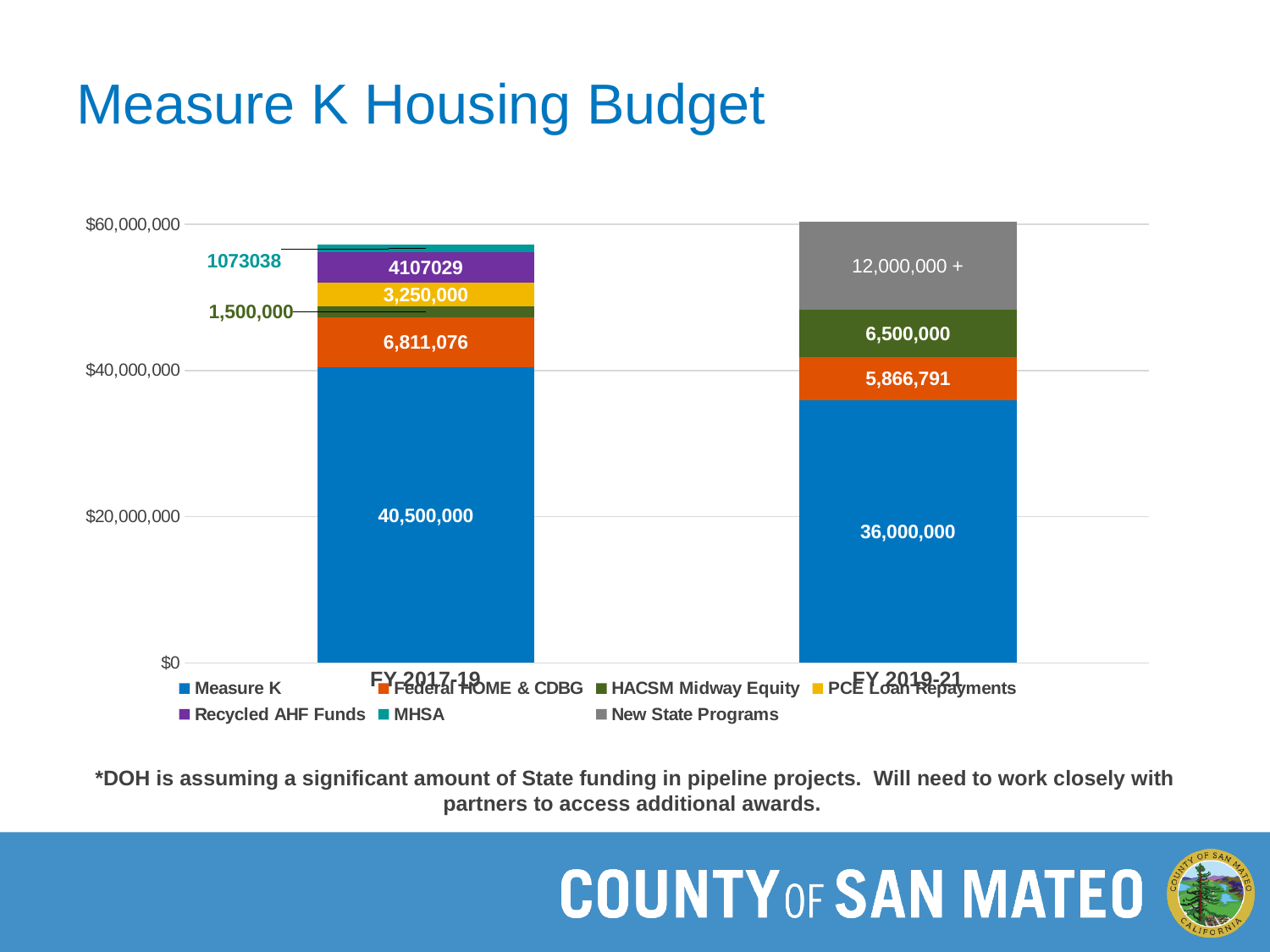
What is the PCE Loan Repayments value for FY 2017-19? 3,250,000 What is the HACSM Midway Equity value for FY 2019-21? 6,500,000 How many series does the legend list? 7 What is the total of the FY 2017-19 stacked bar? 57,241,143 How much larger is the Measure K value in FY 2017-19 than in FY 2019-21? 4,500,000 Which fiscal year has the larger Federal HOME & CDBG value, FY 2017-19 or FY 2019-21? FY 2017-19 How many fiscal-year categories are shown on the x axis? 2 What is the label shown for New State Programs in FY 2019-21? 12,000,000 + What is the Federal HOME & CDBG value for FY 2019-21? 5,866,791 What is the Measure K value for FY 2019-21? 36,000,000 What type of chart is shown on the slide? Stacked bar chart What is the Measure K value for FY 2017-19? 40,500,000